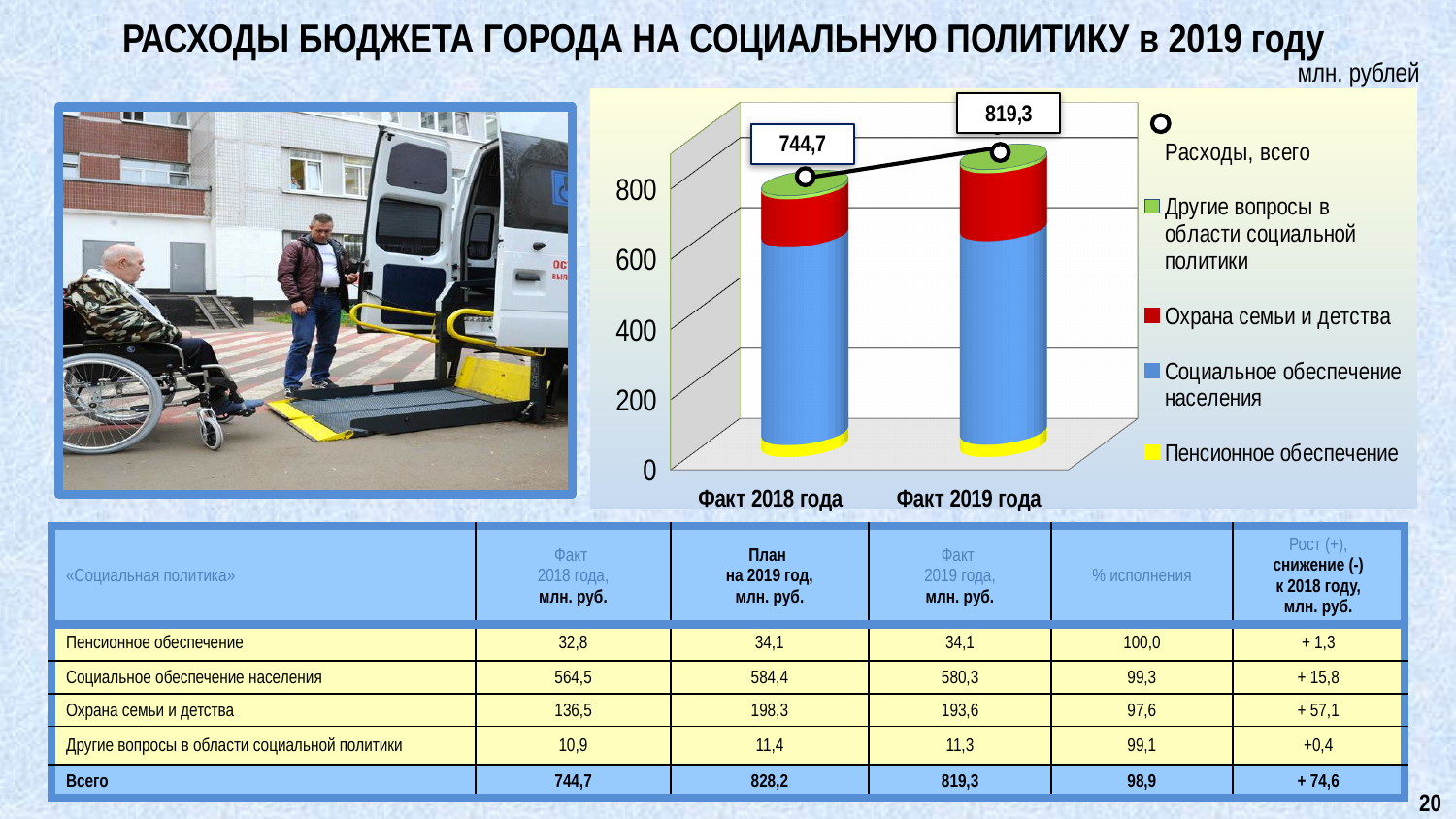
Which is larger, «Расходы, всего» for Факт 2018 года or for Факт 2019 года? Факт 2019 года Do the total expenditures rise or fall from Факт 2018 года to Факт 2019 года? rise By how much does «Расходы, всего» for Факт 2019 года exceed the value for Факт 2018 года? 74,6 What kind of chart is shown on the slide? bar chart How many categories are shown on the x axis of the chart? 2 What is the value of «Расходы, всего» for Факт 2018 года? 744,7 Is the value of «Расходы, всего» for Факт 2018 года greater or less than 600? greater What colour represents «Пенсионное обеспечение» in the chart? yellow Which category has the lowest total expenditure? Факт 2018 года Which category has the highest total expenditure? Факт 2019 года What is the value of «Расходы, всего» for Факт 2019 года? 819,3 How many entries does the chart legend list? 5